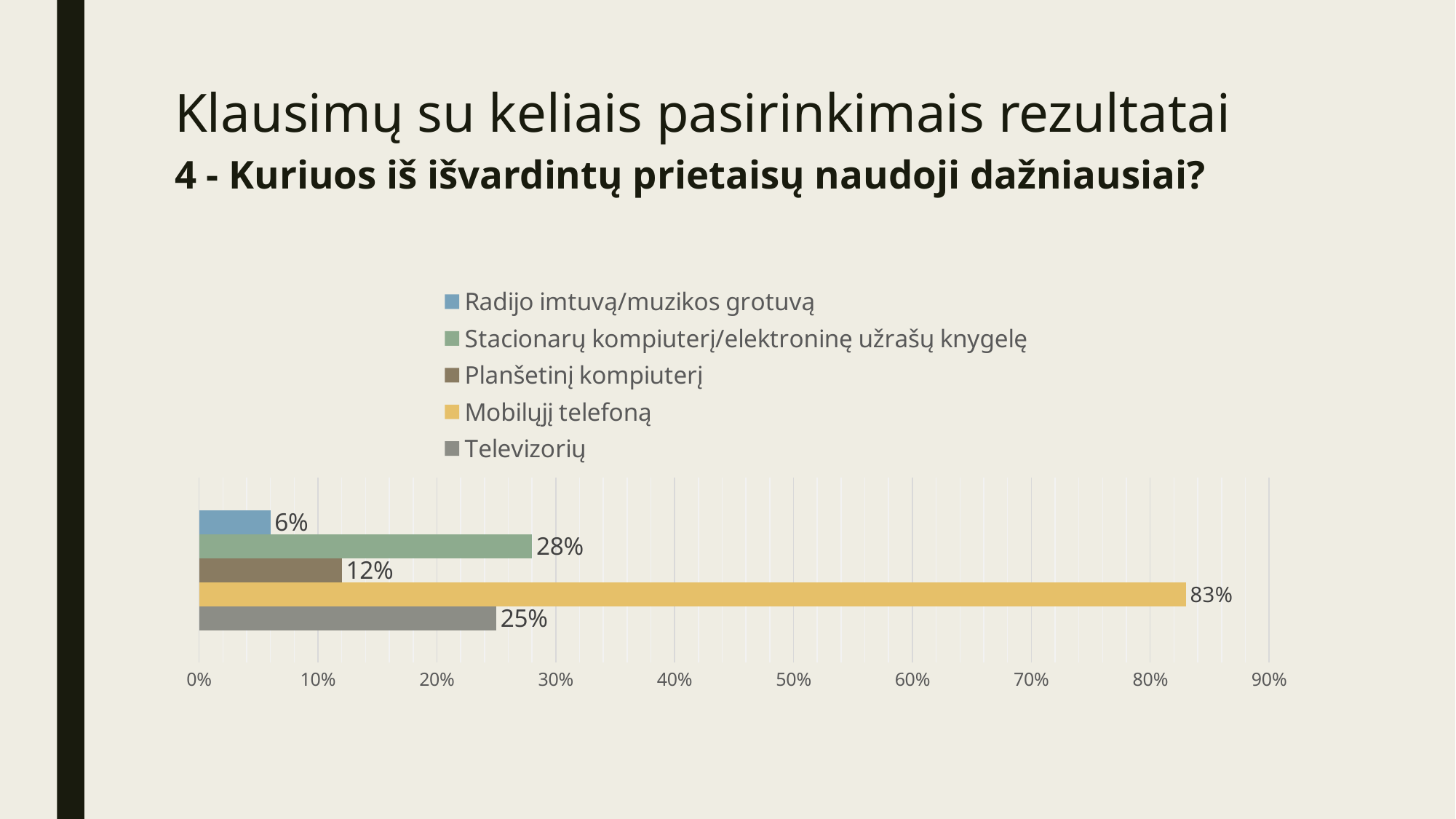
Which is larger, the value for Stacionarų kompiuterį/elektroninę užrašų knygelę or the value for Televizorių? Stacionarų kompiuterį/elektroninę užrašų knygelę What kind of chart is shown on the slide? bar chart What is the value for Televizorių? 25% What is the difference between the values for Mobilųjį telefoną and Stacionarų kompiuterį/elektroninę užrašų knygelę? 55% Which device has the highest value? Mobilųjį telefoną What is the value for Radijo imtuvą/muzikos grotuvą? 6% Is the value for Planšetinį kompiuterį greater or less than 10%? greater What is the value for Planšetinį kompiuterį? 12% What colour is the bar for Mobilųjį telefoną? yellow Which device has the lowest value? Radijo imtuvą/muzikos grotuvą How many series does the legend list? 5 What is the value for Mobilųjį telefoną? 83%